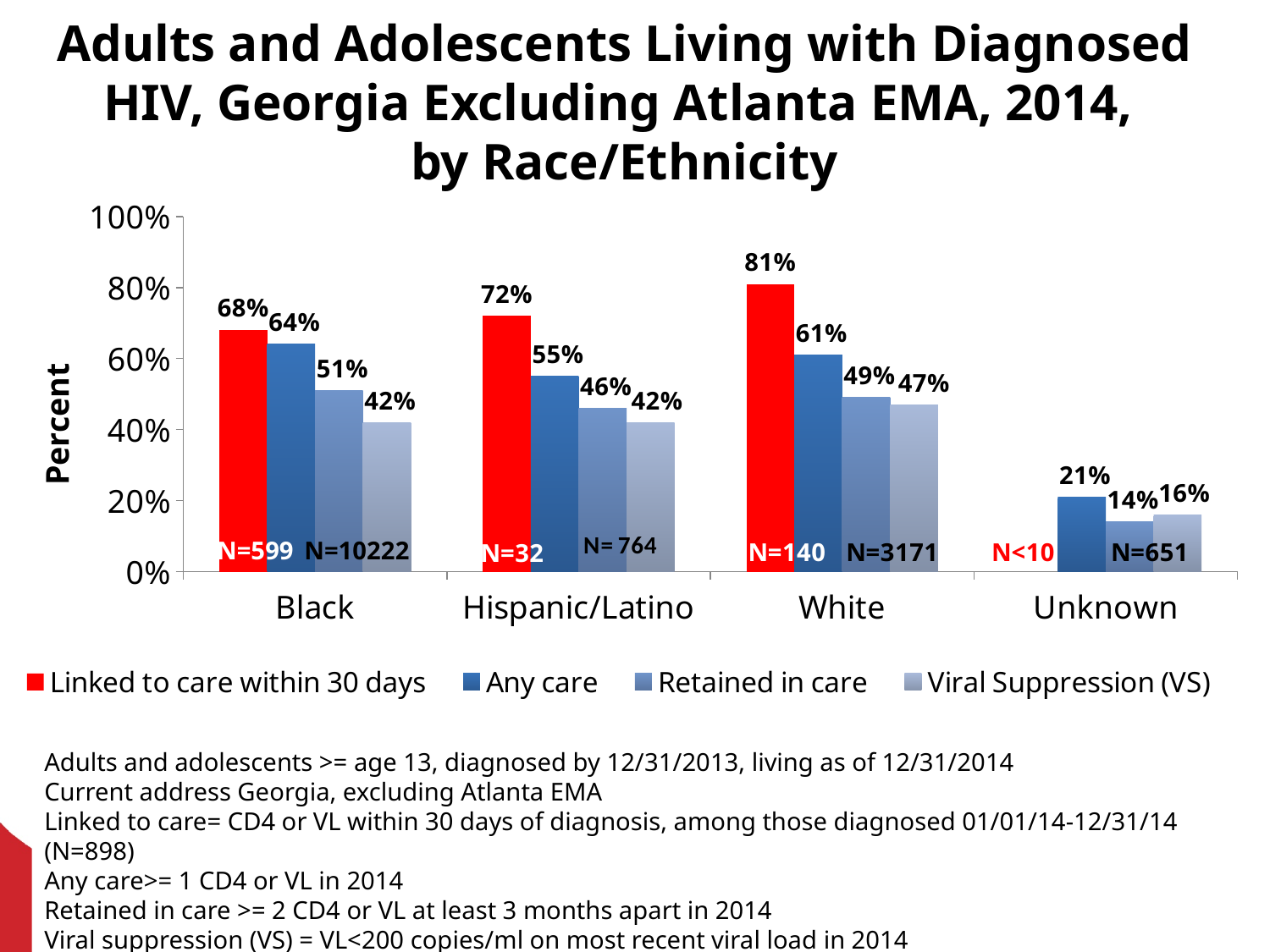
How many race/ethnicity categories are shown on the x axis? 4 What percentage of White adults and adolescents were linked to care within 30 days? 81% What is the N value shown for the Linked to care within 30 days bar in the Black group? N=599 What is the difference between the Any care and Retained in care values for the Black group? 13% Which race/ethnicity group has the highest value for Linked to care within 30 days? White What kind of chart is shown on the slide? Bar chart Which race/ethnicity group has the lowest Retained in care value? Unknown What is the Any care value for the Unknown race/ethnicity group? 21% What colour is the Linked to care within 30 days series in the legend? Red How many series does the legend list? 4 What is the Viral Suppression (VS) value for the Hispanic/Latino group? 42% Which is larger for the White group: Retained in care or Viral Suppression (VS)? Retained in care